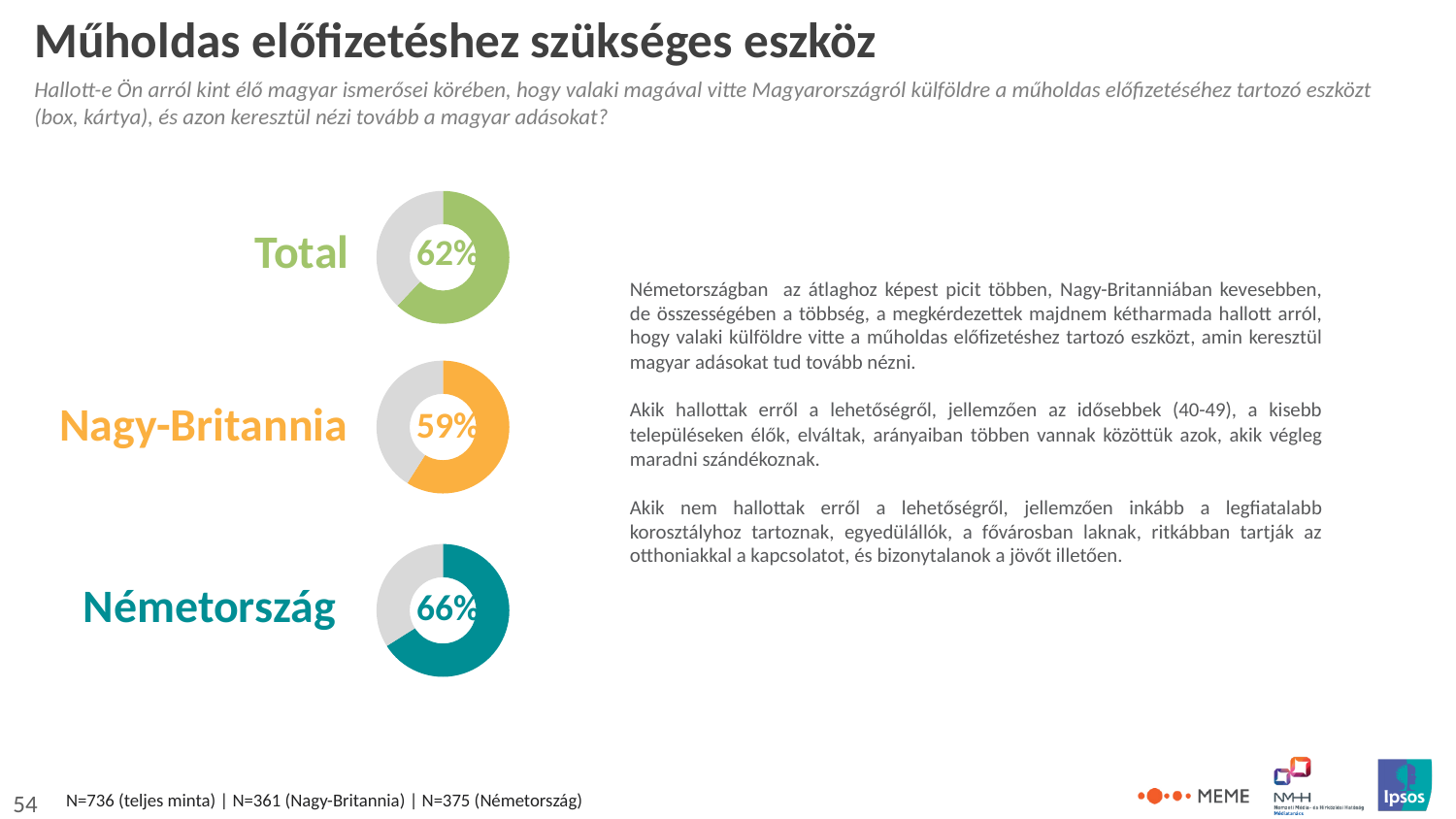
In the Németország donut chart, what colour is the highlighted slice? Teal What is the difference between the percentage in the Németország donut chart and the percentage in the Total donut chart? 4 percentage points In the Nagy-Britannia donut chart, what colour is the highlighted slice? Orange In the Németország donut chart, what percentage is shown? 66% Across the three donut charts, which group has the lowest percentage? Nagy-Britannia In the Total donut chart, what percentage is shown? 62% In the Nagy-Britannia donut chart, what percentage is shown? 59% Comparing the Total donut chart and the Nagy-Britannia donut chart, which shows the larger percentage? Total What type of chart is used to show the Total value? Donut (pie) chart Across the three donut charts, which group has the highest percentage? Németország What is the difference between the percentage in the Németország donut chart and the percentage in the Nagy-Britannia donut chart? 7 percentage points How many donut charts are on the slide? 3